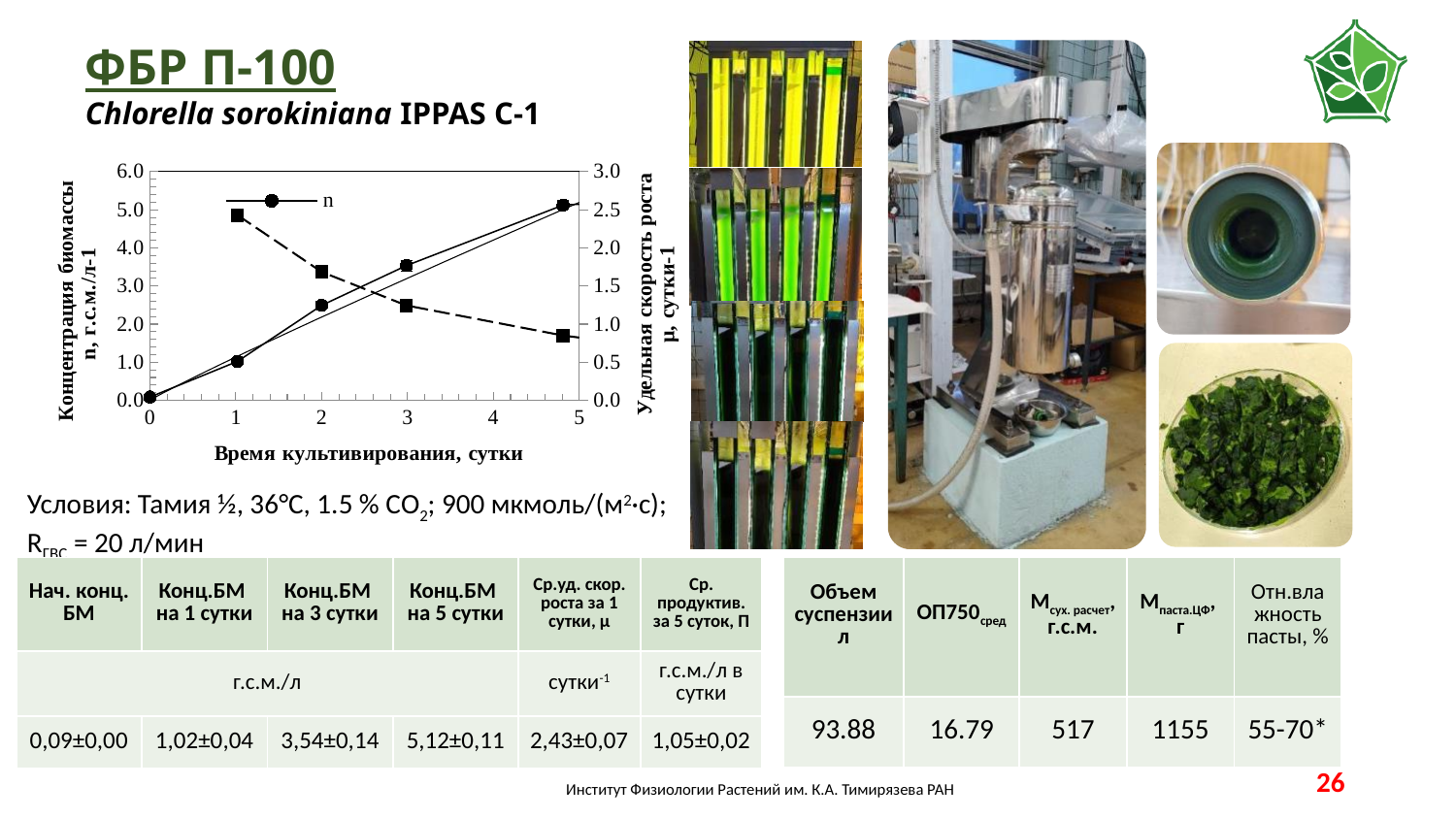
Is the final biomass concentration n (last point of the solid line) greater or less than 4.0 on the left axis? greater Is the biomass concentration n at day 1 greater or less than 2.0 on the left axis? less Is the biomass concentration n at day 2 greater or less than 3.0 on the left axis? less How many data points are plotted for the biomass concentration n series (circles)? 5 What is the title of the right y axis of the chart? Удельная скорость роста μ, сутки-1 What kind of chart is shown on the slide? line chart Does the specific growth rate μ (dashed line with squares) rise or fall as cultivation time increases? falls Does the biomass concentration n (solid line with circles) rise or fall as cultivation time increases? rises What is the title of the x axis of the chart? Время культивирования, сутки